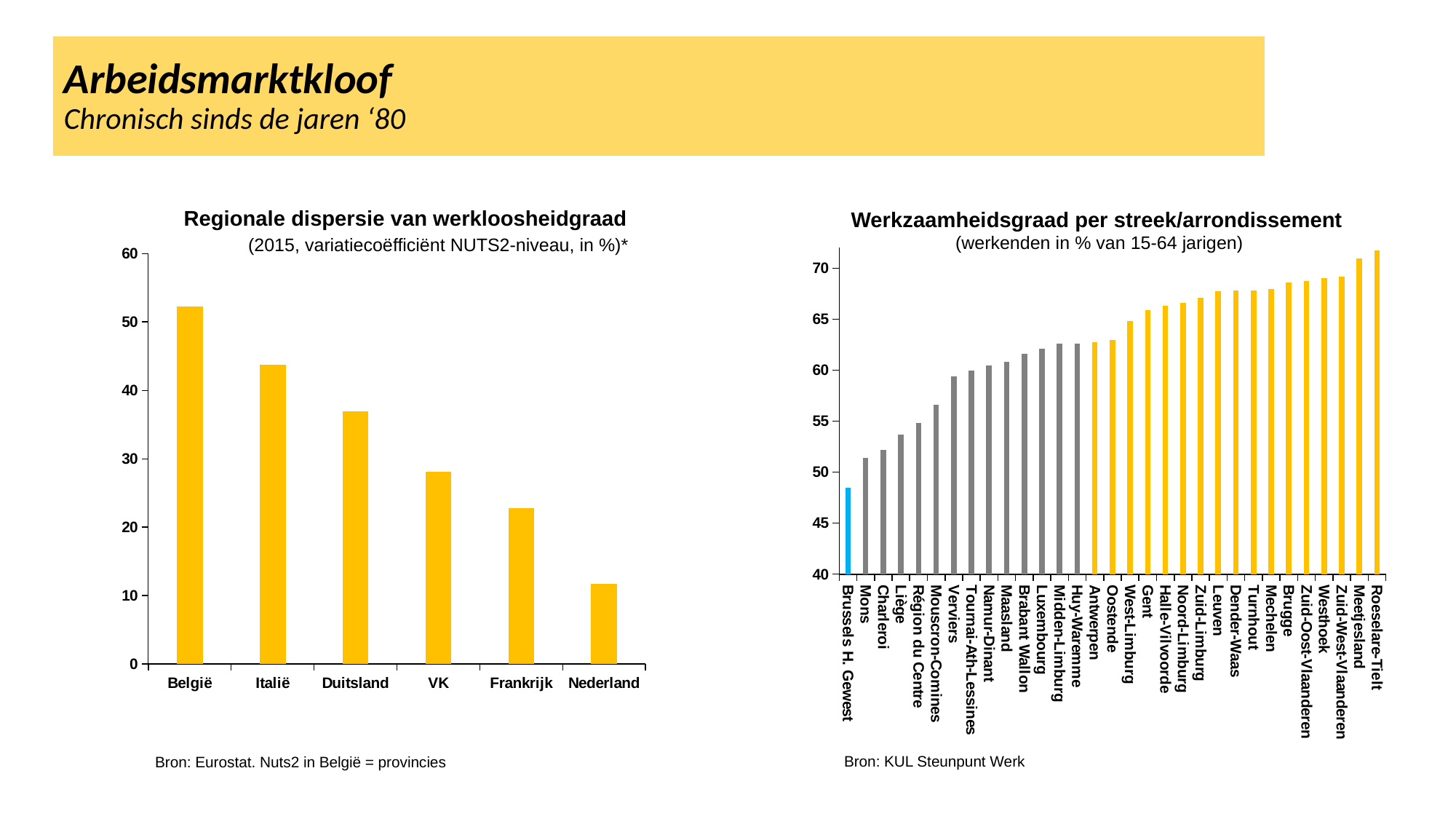
In the chart 'Regionale dispersie van werkloosheidgraad', is the value for België greater or less than 50? greater In the chart 'Werkzaamheidsgraad per streek/arrondissement', which region has the lowest value? Brussels H. Gewest In the chart 'Regionale dispersie van werkloosheidgraad', which is larger, the value for Italië or the value for Duitsland? Italië In the chart 'Werkzaamheidsgraad per streek/arrondissement', is the value for Brussels H. Gewest greater or less than 50? less In the chart 'Regionale dispersie van werkloosheidgraad', which country has the highest value? België In the chart 'Werkzaamheidsgraad per streek/arrondissement', which bar is coloured blue rather than grey or yellow? Brussels H. Gewest In the chart 'Werkzaamheidsgraad per streek/arrondissement', do the values rise or fall from left to right along the x axis? rise How many countries are shown in the chart 'Regionale dispersie van werkloosheidgraad'? 6 In the chart 'Regionale dispersie van werkloosheidgraad', is the value for Nederland greater or less than 20? less What kind of chart is 'Regionale dispersie van werkloosheidgraad'? bar chart In the chart 'Regionale dispersie van werkloosheidgraad', which country has the lowest value? Nederland In the chart 'Werkzaamheidsgraad per streek/arrondissement', which region has the highest value? Roeselare-Tielt